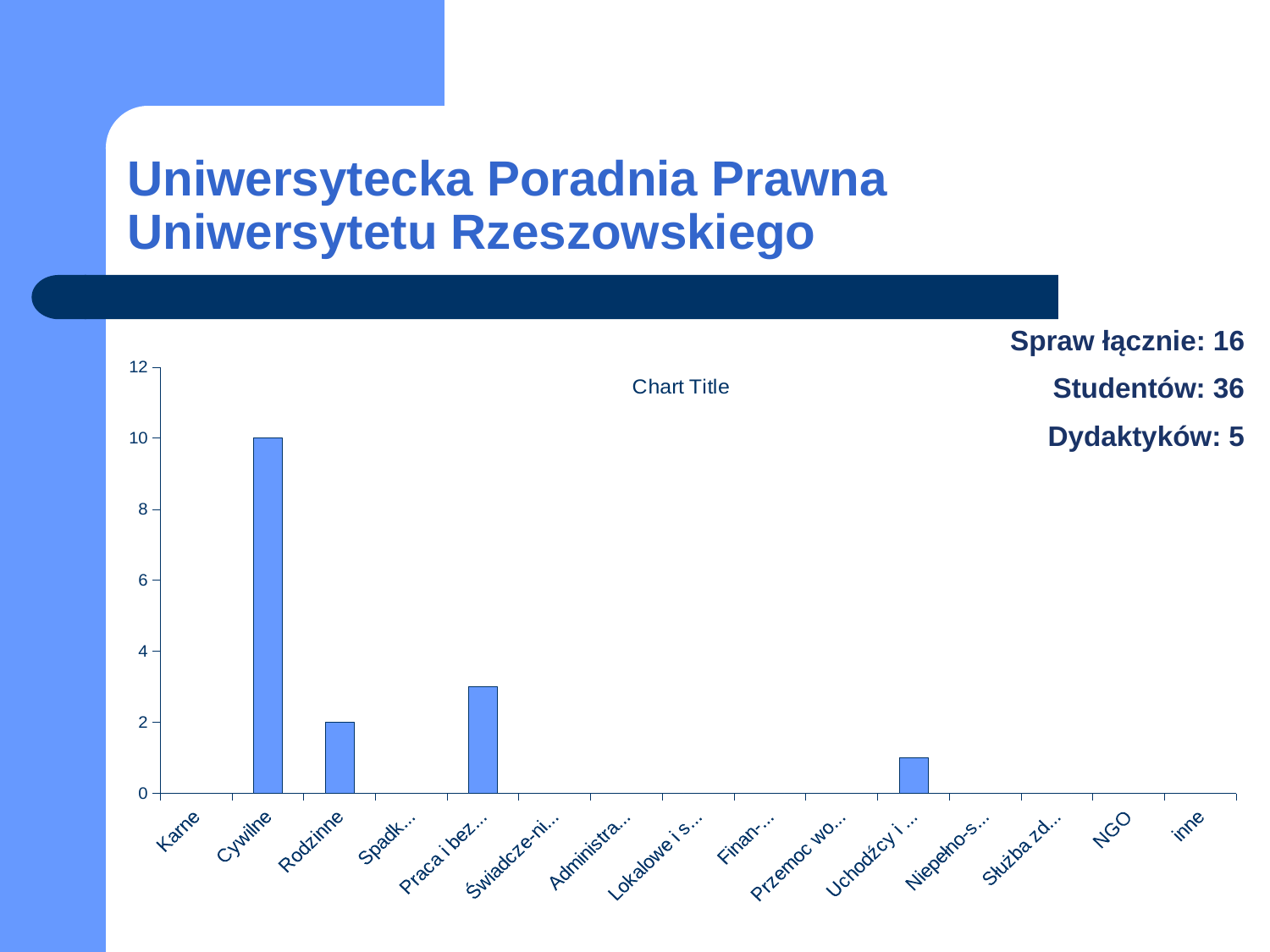
Is the value for Praca i bez... greater or less than 4? less How many categories are shown on the x axis of the chart? 15 What is the value for Cywilne? 10 Is the value for Praca i bez... greater or less than 2? greater Which is larger, the value for Cywilne or the value for Rodzinne? Cywilne Is the value for Uchodźcy i ... greater or less than 2? less What kind of chart is shown on the slide? bar chart What is the value for Rodzinne? 2 Which category has the highest value in the chart? Cywilne Which is larger, the value for Rodzinne or the value for Praca i bez...? Praca i bez... What is the title shown on the chart? Chart Title What is the difference between the values for Cywilne and Rodzinne? 8